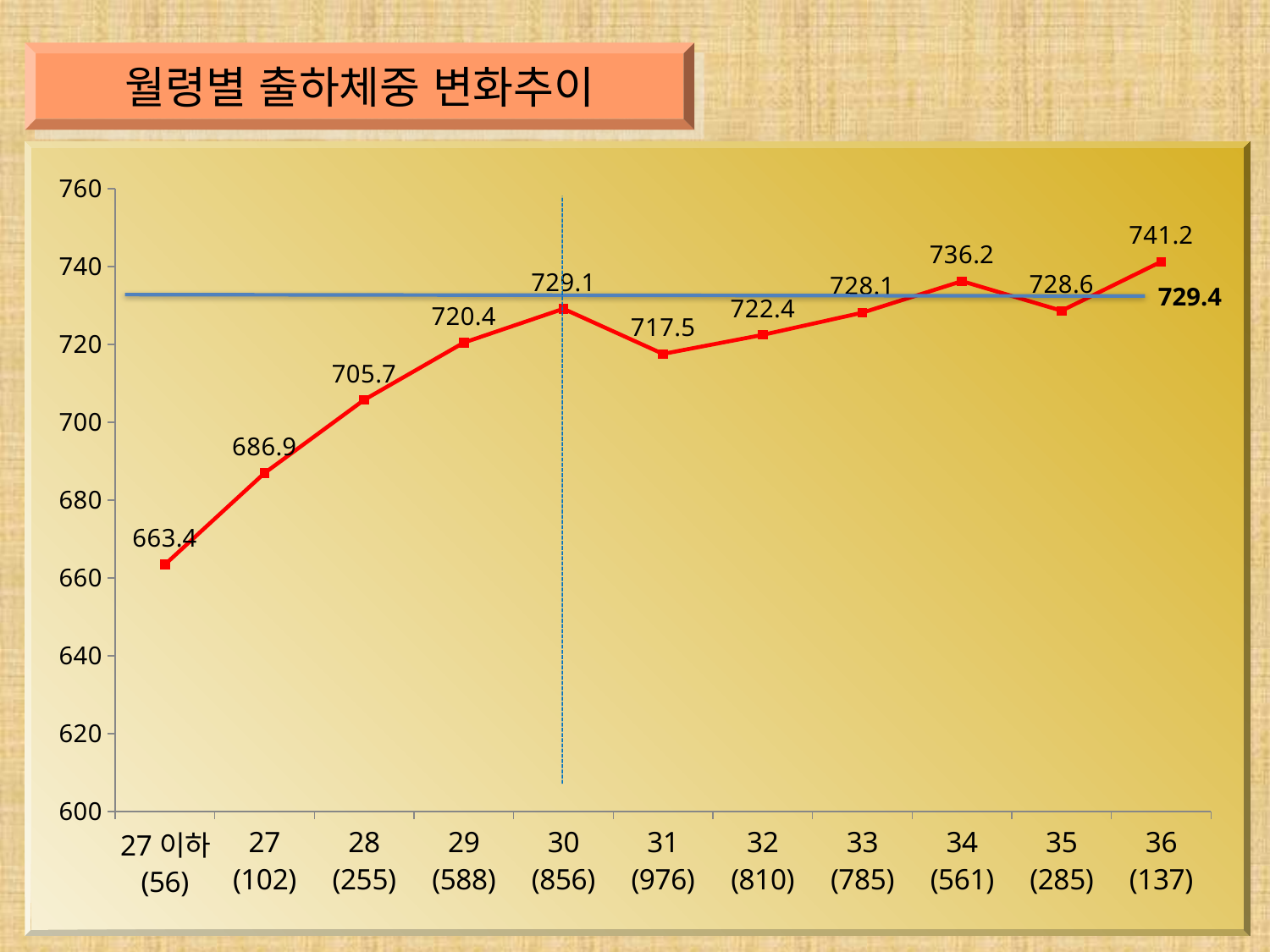
What is the value plotted for the category 27 이하? 663.4 Which category has the lowest plotted value? 27 이하 What kind of chart is shown on the slide? line chart Do the plotted values rise or fall from 27 이하 to month 30? rise What is the difference between the values for month 36 and month 35? 12.6 Which is larger, the value for month 31 or the value for month 32? 32 What is the shipping weight value plotted for month 30? 729.1 What is the title of the chart? 월령별 출하체중 변화추이 What is the value plotted for month 34? 736.2 Which category has the highest plotted value? 36 What value is labelled on the horizontal reference line? 729.4 How many categories are shown on the x axis? 11